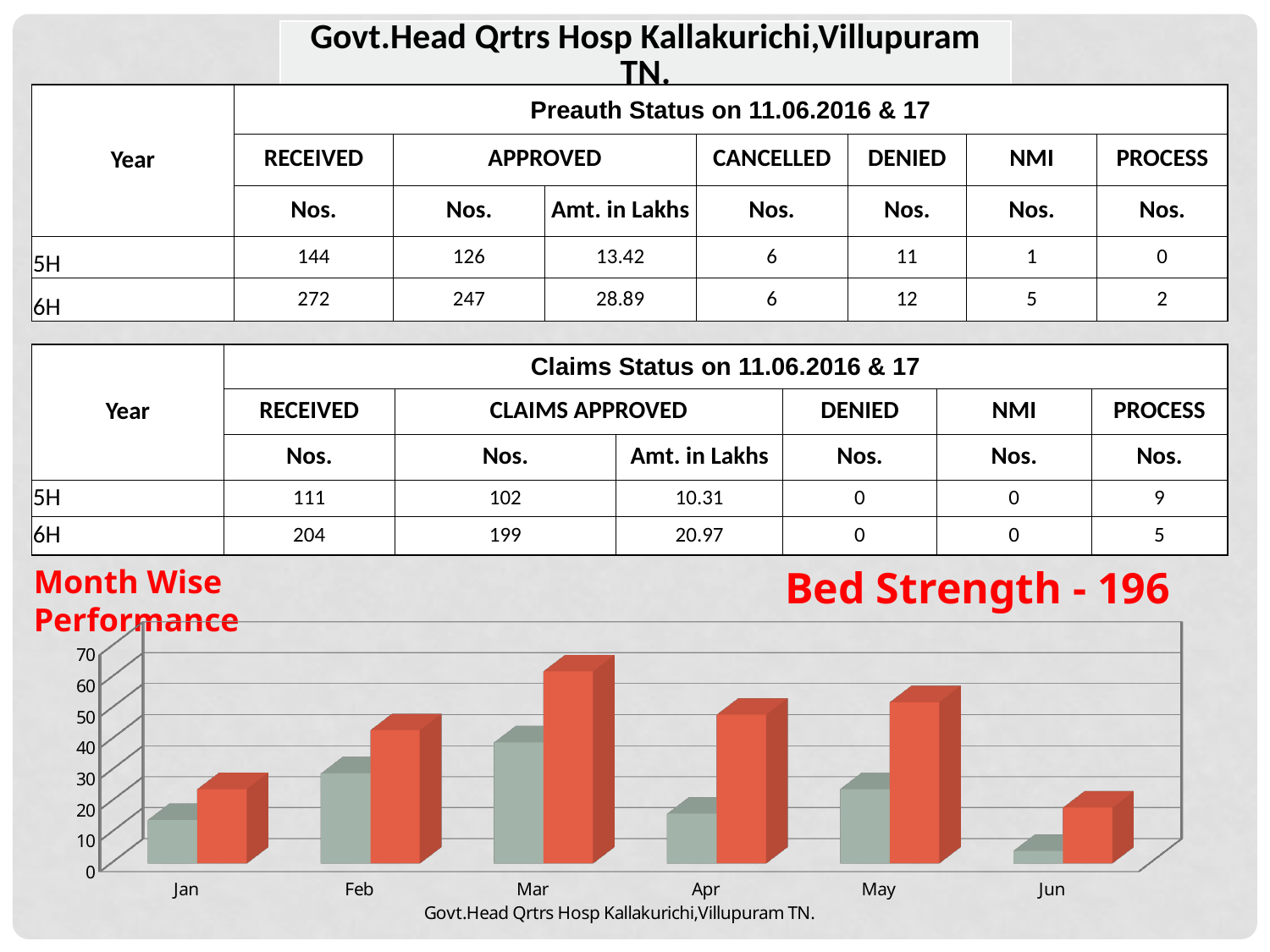
In the bar chart, which month has the tallest grey bar? Mar Is the value of the red bar for Mar greater or less than 50? greater What kind of chart is shown at the bottom of the slide? bar chart What is the highest value shown on the y axis of the bar chart? 70 In the bar chart, which month has the shortest red bar? Jun Is the value of the red bar for Jan greater or less than 40? less How many months are shown on the x axis of the bar chart? 6 In the bar chart, which is larger for Feb: the grey bar or the red bar? the red bar In the bar chart, which month has the tallest red bar? Mar How many bars are plotted for each month in the bar chart? 2 Is the value of the grey bar for Jun greater or less than 10? less In the bar chart, which month has the shortest grey bar? Jun